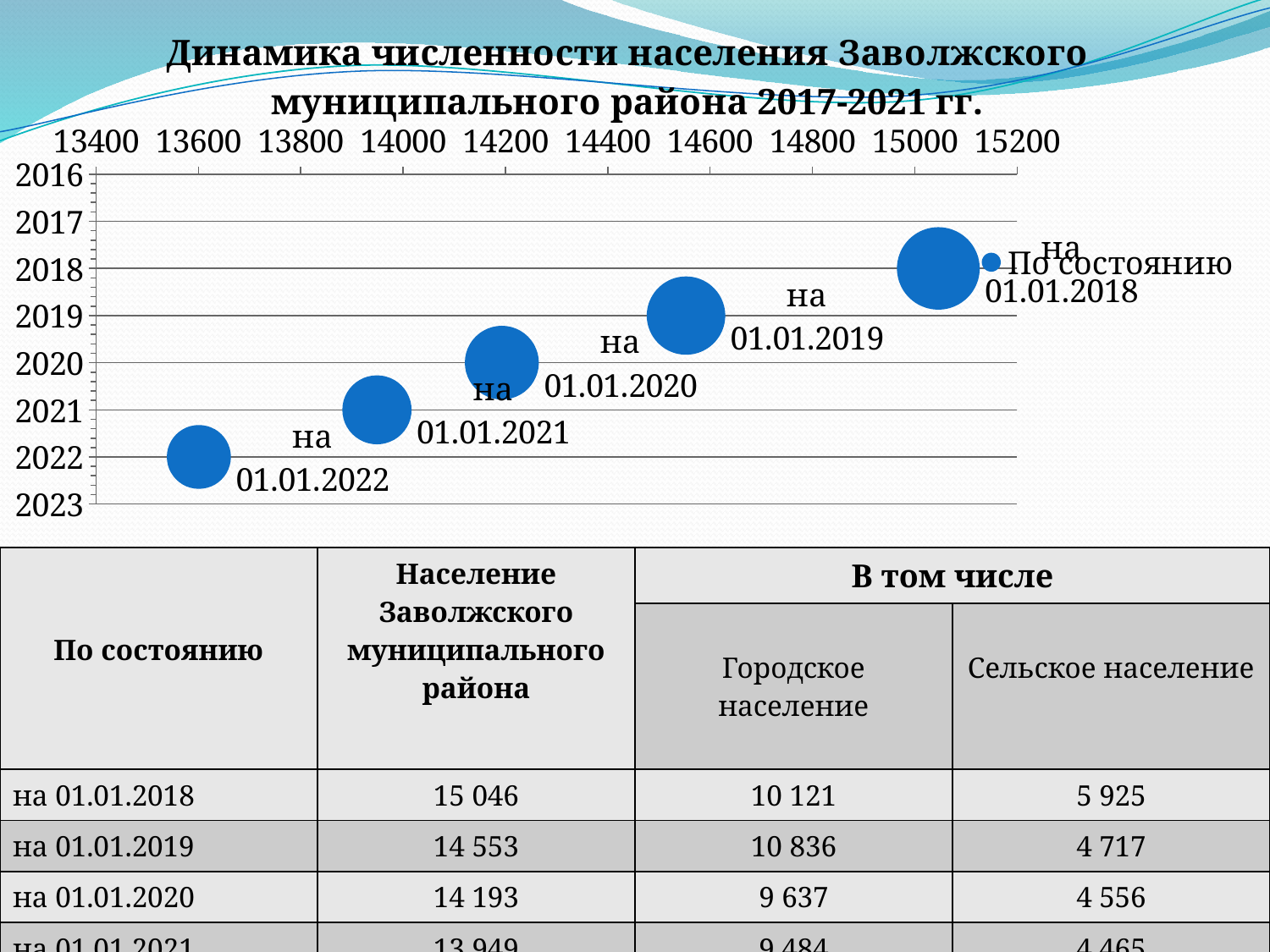
What kind of chart is shown on the slide? bubble chart How many data points (bubbles) are plotted on the chart? 5 How many series does the chart legend list? 1 Is the value for на 01.01.2022 greater or less than 13800? less What is the title of the chart? Динамика численности населения Заволжского муниципального района 2017-2021 гг. Does the population value rise or fall from на 01.01.2018 to на 01.01.2022? fall Is the value for на 01.01.2019 greater or less than 14400? greater What is the name of the series shown in the chart legend? По состоянию Is the value for на 01.01.2018 greater or less than 15000? greater Which data point has the highest population value on the chart? на 01.01.2018 Which data point has the lowest population value on the chart? на 01.01.2022